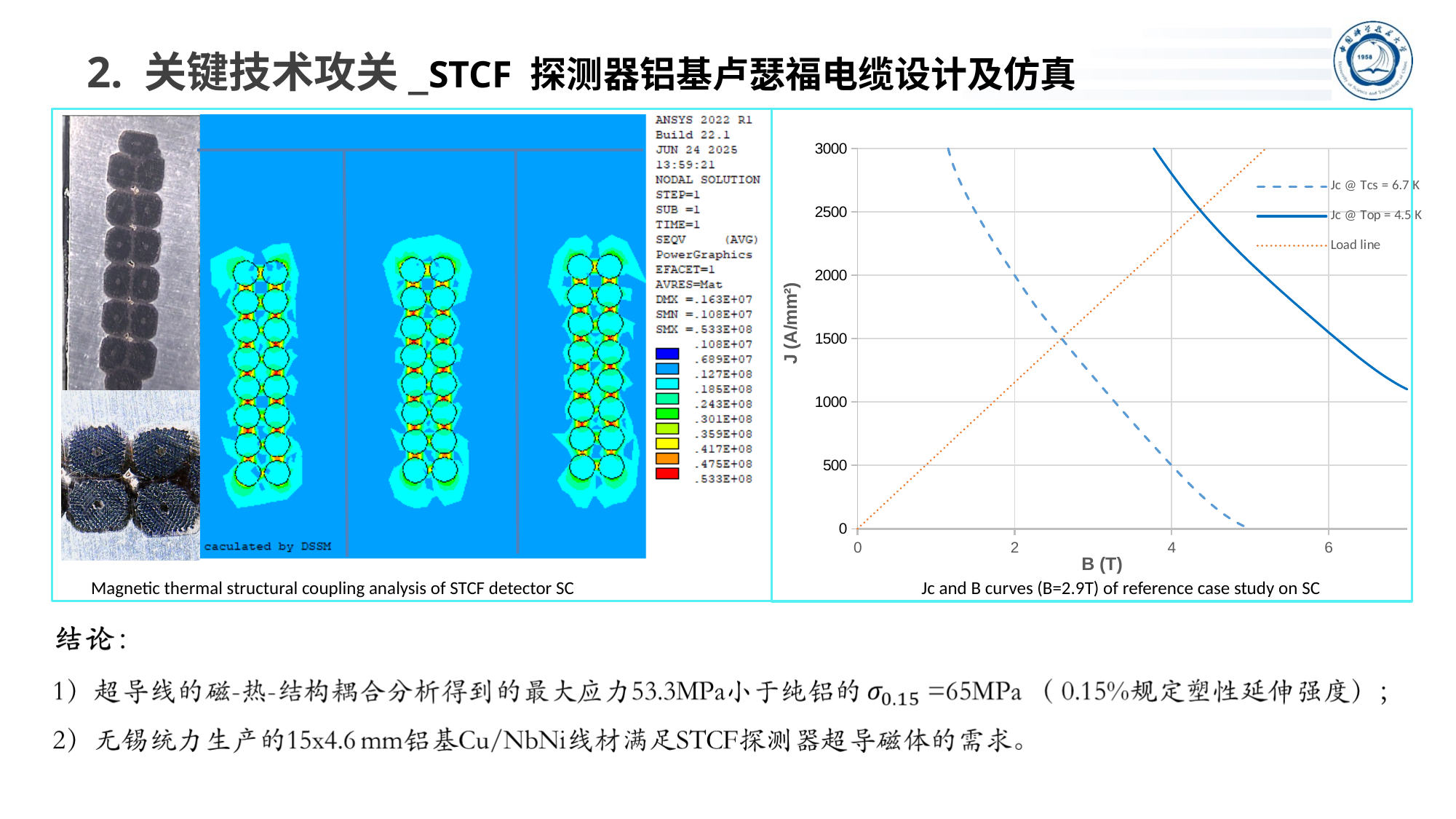
How many series does the legend of the Jc and B curves chart list? 3 In the Jc and B curves chart, does the 'Jc @ Tcs = 6.7 K' curve rise or fall as B increases? fall In the Jc and B curves chart, at B = 4 T, is the value of 'Jc @ Top = 4.5 K' greater or less than 2500? greater What is the label of the vertical axis of the Jc and B curves chart? J (A/mm²) What kind of chart is shown on the right side of the slide? line chart In the Jc and B curves chart, at B = 2 T, which is larger: 'Jc @ Tcs = 6.7 K' or 'Load line'? Jc @ Tcs = 6.7 K In the Jc and B curves chart, at B = 4 T, is the value of the 'Load line' greater or less than 2000? greater In the Jc and B curves chart, at B = 2 T, is the value of the 'Load line' greater or less than 1000? greater What is the label of the horizontal axis of the Jc and B curves chart? B (T) In the Jc and B curves chart, does the 'Load line' rise or fall as B increases? rise In the Jc and B curves chart, at B = 4 T, which is larger: 'Jc @ Top = 4.5 K' or 'Jc @ Tcs = 6.7 K'? Jc @ Top = 4.5 K In the Jc and B curves chart, does the 'Jc @ Top = 4.5 K' curve rise or fall as B increases? fall